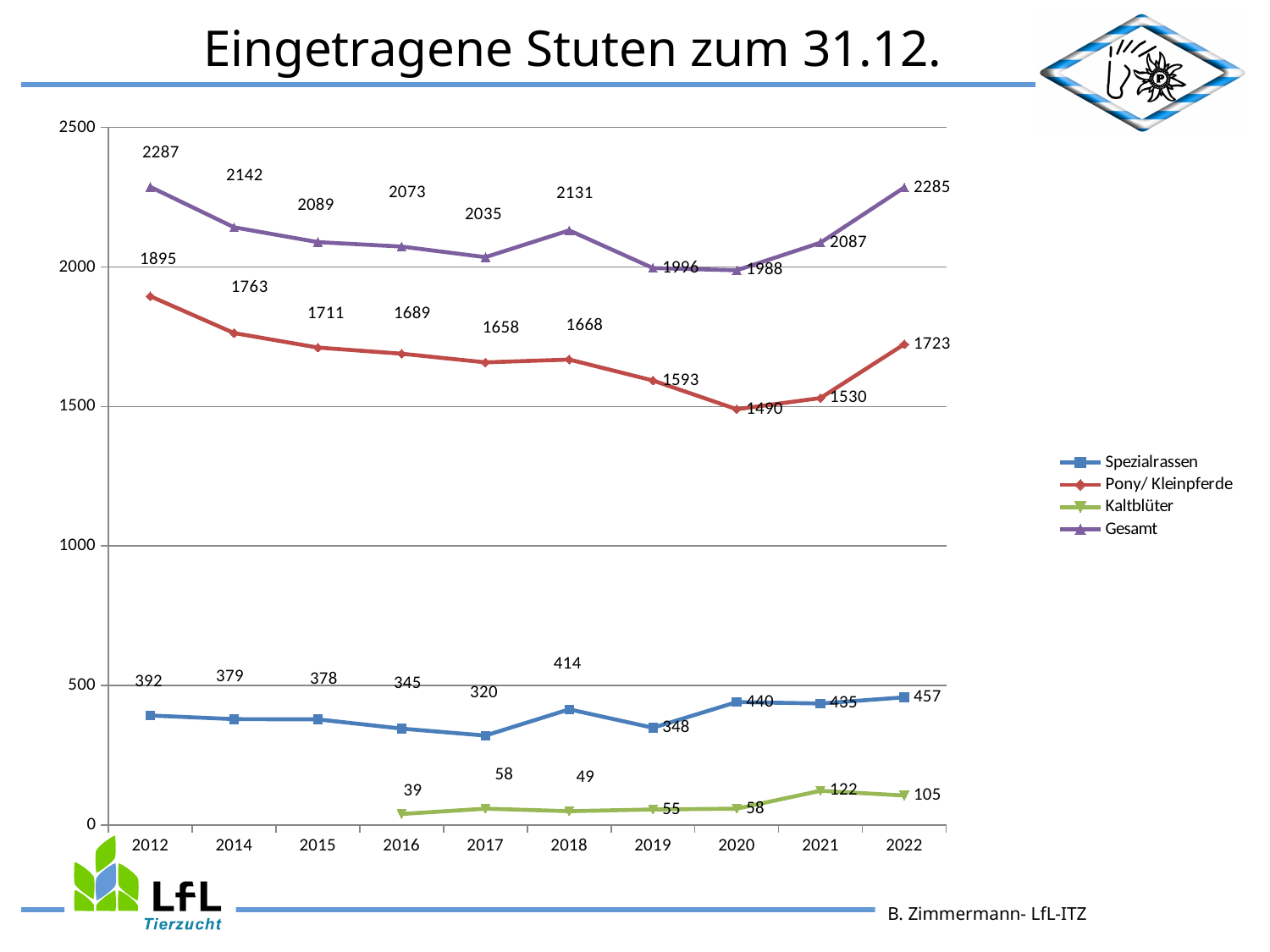
Which series is drawn in green in the legend? Kaltblüter What is the value of the Gesamt series in 2012? 2287 Does the Pony/ Kleinpferde series rise or fall from 2012 to 2020? fall How many years are shown on the x axis? 10 In which year does the Pony/ Kleinpferde series reach its lowest value? 2020 What kind of chart is shown on the slide? line chart How many series does the legend list? 4 Which year has the larger Spezialrassen value, 2018 or 2019? 2018 What is the value of the Kaltblüter series in 2021? 122 What is the difference between the Gesamt value in 2012 and the Gesamt value in 2022? 2 What is the value of the Pony/ Kleinpferde series in 2020? 1490 In which year does the Spezialrassen series reach its highest value? 2022